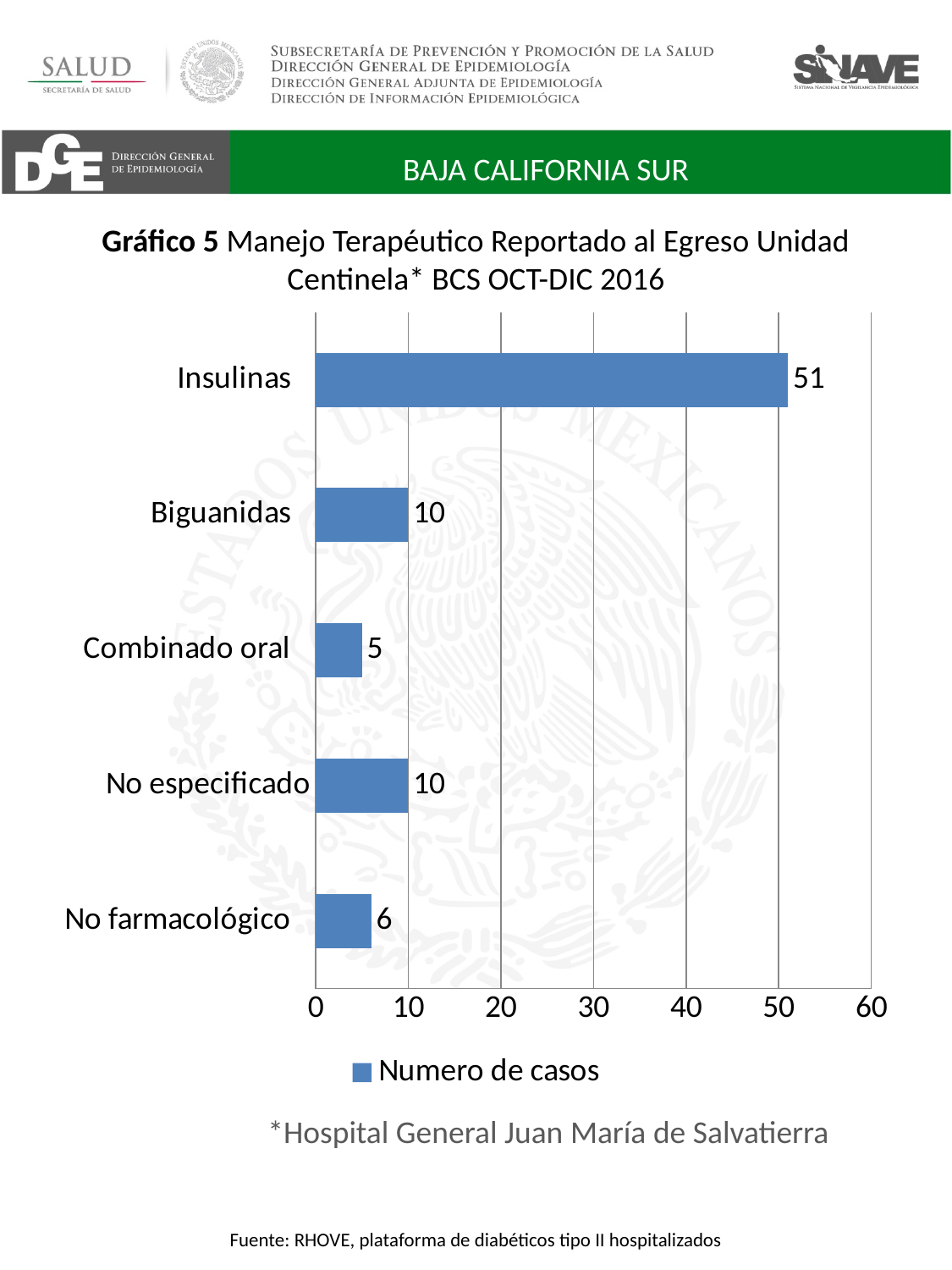
What kind of chart is shown on the slide? bar chart What is the legend entry for the series shown in the chart? Numero de casos How many series does the legend list? 1 How many categories are shown in the chart? 5 Which category has the lowest number of cases? Combinado oral Is the value for Insulinas greater or less than 40? greater What is the difference in number of cases between Insulinas and Biguanidas? 41 What is the number of cases for No farmacológico? 6 Which has more cases, No farmacológico or Combinado oral? No farmacológico What is the number of cases for Combinado oral? 5 What is the number of cases for Insulinas? 51 Which category has the highest number of cases? Insulinas